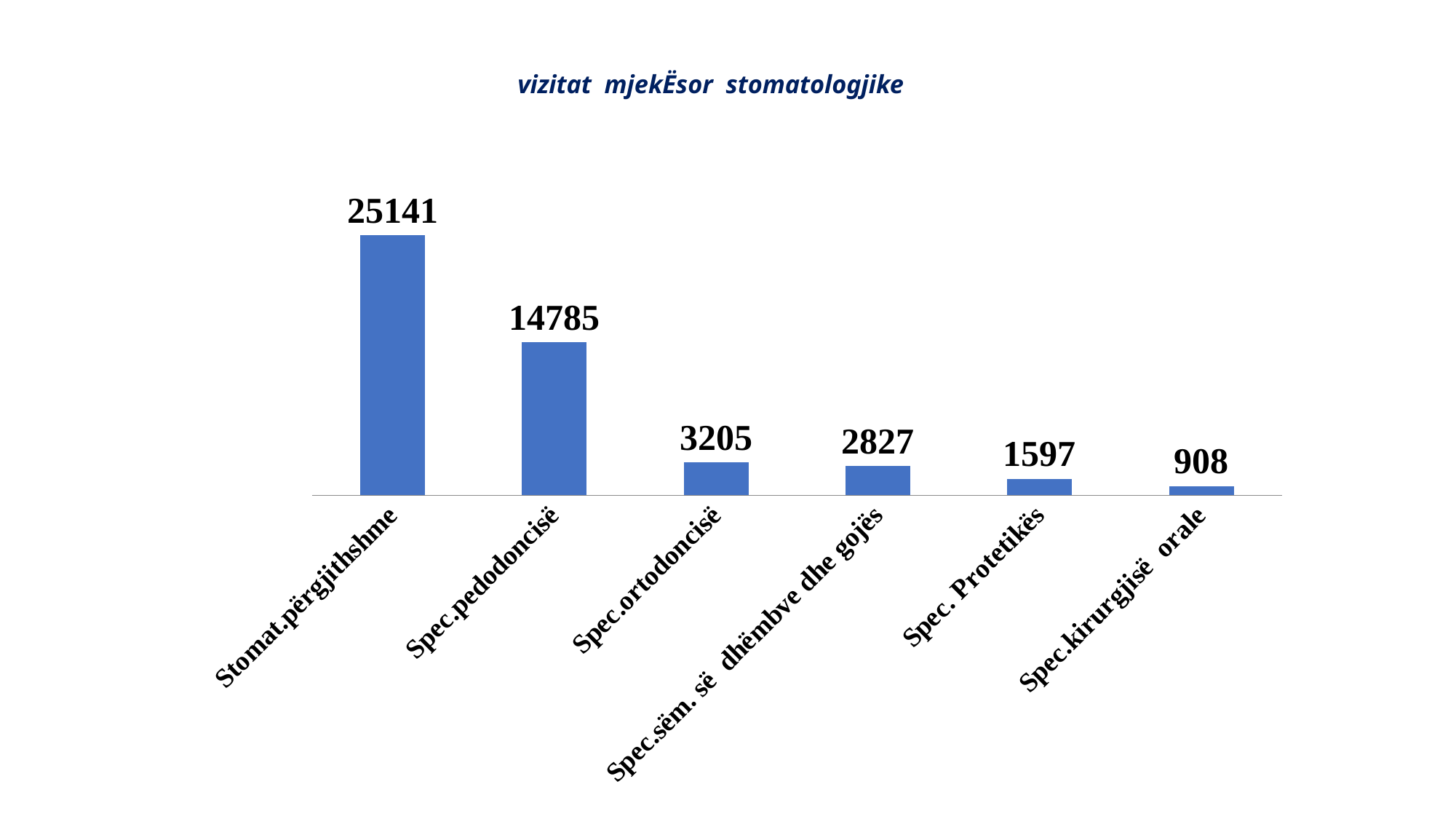
What is the value for Spec. Protetikës? 1597 What is the value for Stomat.përgjithshme? 25141 How many categories are shown in the chart? 6 Which is larger, the value for Spec. Protetikës or the value for Spec.kirurgjisë orale? Spec. Protetikës What is the value for Spec.ortodoncisë? 3205 Which category has the lowest value? Spec.kirurgjisë orale What is the difference between the values for Stomat.përgjithshme and Spec.pedodoncisë? 10356 What is the value for Spec.pedodoncisë? 14785 What is the value for Spec.kirurgjisë orale? 908 What kind of chart is shown on the slide? Bar chart Which category has the highest value? Stomat.përgjithshme What is the difference between the values for Spec.ortodoncisë and Spec.sëm. së dhëmbve dhe gojës? 378